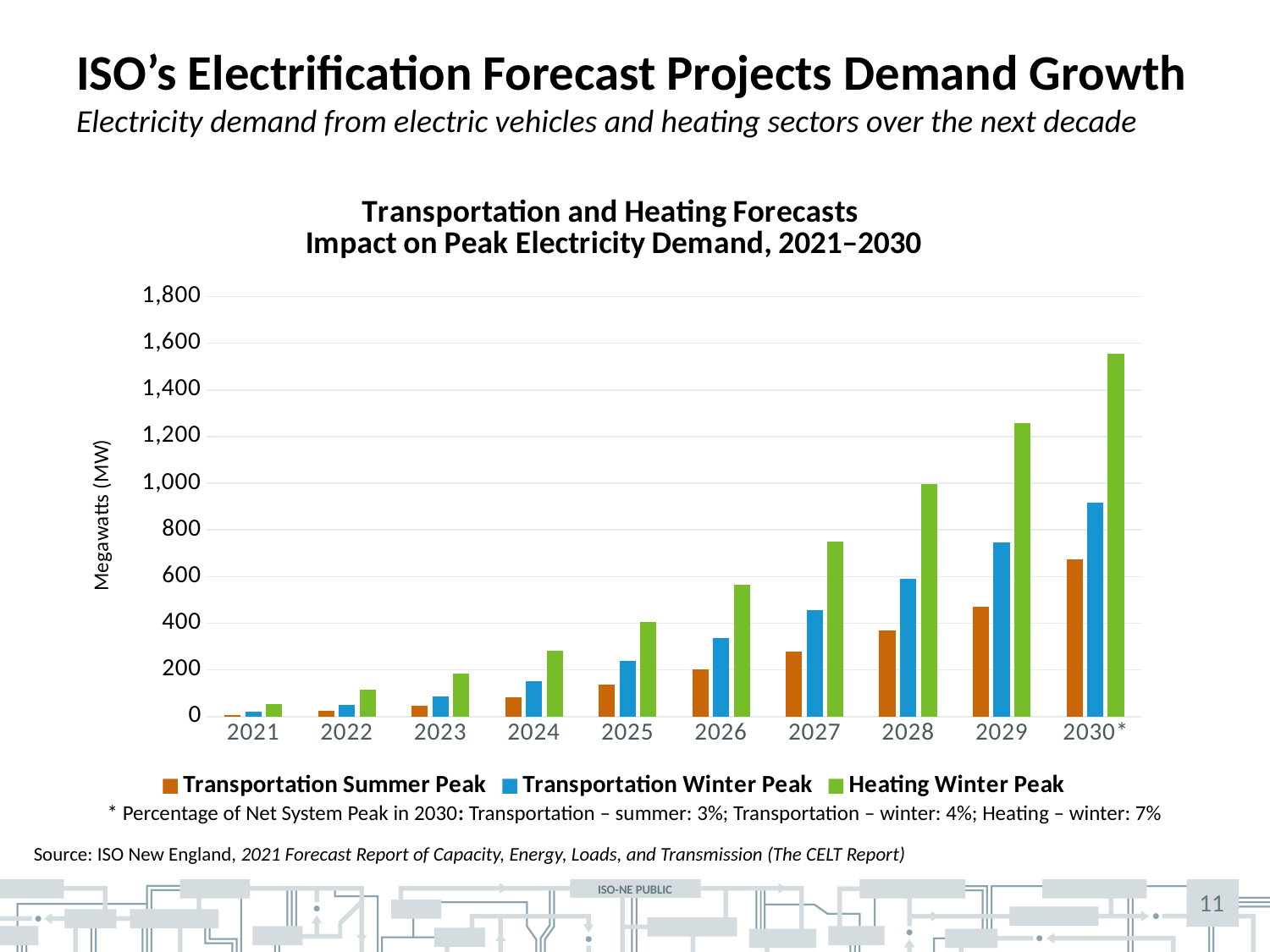
How many series does the legend list? 3 How many years are shown along the x axis? 10 Is the Transportation Winter Peak value for 2030 greater or less than 1,000? less Do the Heating Winter Peak values rise or fall from 2021 to 2030? Rise In 2030, which is larger: Transportation Winter Peak or Heating Winter Peak? Heating Winter Peak Is the Heating Winter Peak value for 2030 greater or less than 1,400? greater What kind of chart is shown on the slide? Bar chart What unit is shown on the y axis? Megawatts (MW) Which series has the tallest bar in 2030? Heating Winter Peak Which series has the smallest bar in 2021? Transportation Summer Peak Is the Transportation Summer Peak value for 2029 greater or less than 400? greater Which series is shown in green in the legend? Heating Winter Peak